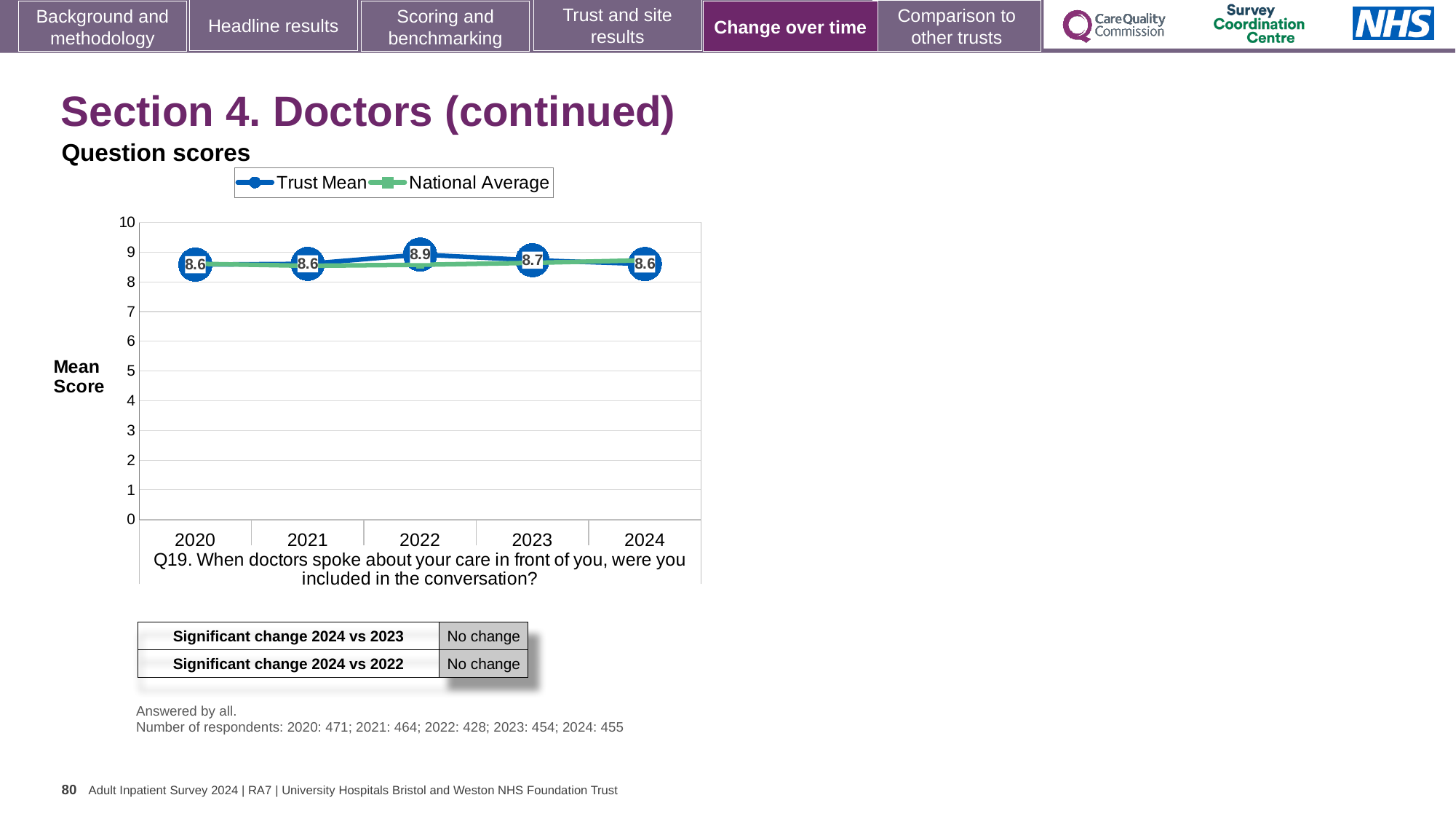
What is the Trust Mean score for 2024? 8.6 Which is larger, the Trust Mean score in 2022 or in 2023? 2022 Is the National Average value for 2024 greater or less than 8? greater What is the difference between the Trust Mean score in 2022 and in 2024? 0.3 What is the Trust Mean score for 2023? 8.7 What kind of chart is shown on the slide? Line chart How many series does the legend list? 2 What is the Trust Mean score for 2022? 8.9 How many years are plotted on the x axis? 5 Does the Trust Mean score rise or fall from 2022 to 2024? Fall What are the two series named in the chart legend? Trust Mean and National Average In which year is the Trust Mean score highest? 2022